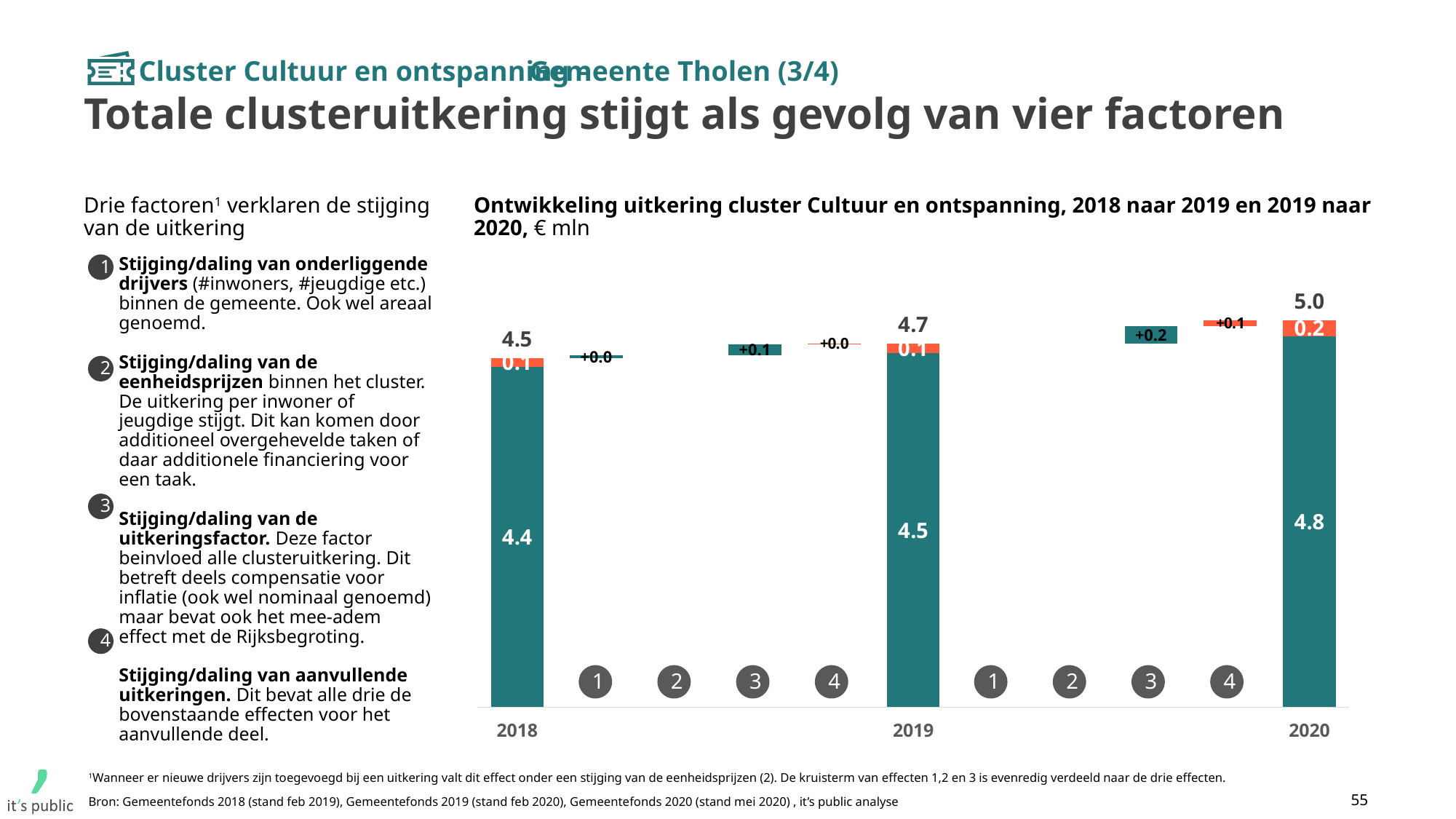
In what unit are the values on the chart expressed? € mln What is the value of the large dark segment of the 2019 bar? 4.5 What is the value of factor 4 between 2019 and 2020? +0.1 What is the difference between the total uitkering in 2020 and in 2018? 0.5 What is the total uitkering for 2020 shown on the chart? 5.0 What is the value of the small orange segment on top of the 2020 bar? 0.2 Which year has the lowest total uitkering? 2018 Does the total uitkering rise or fall from 2018 to 2020? rise Which year has the highest total uitkering? 2020 What is the total uitkering for 2018 shown on the chart? 4.5 What is the value of factor 3 between 2018 and 2019? +0.1 What is the value of factor 3 between 2019 and 2020? +0.2